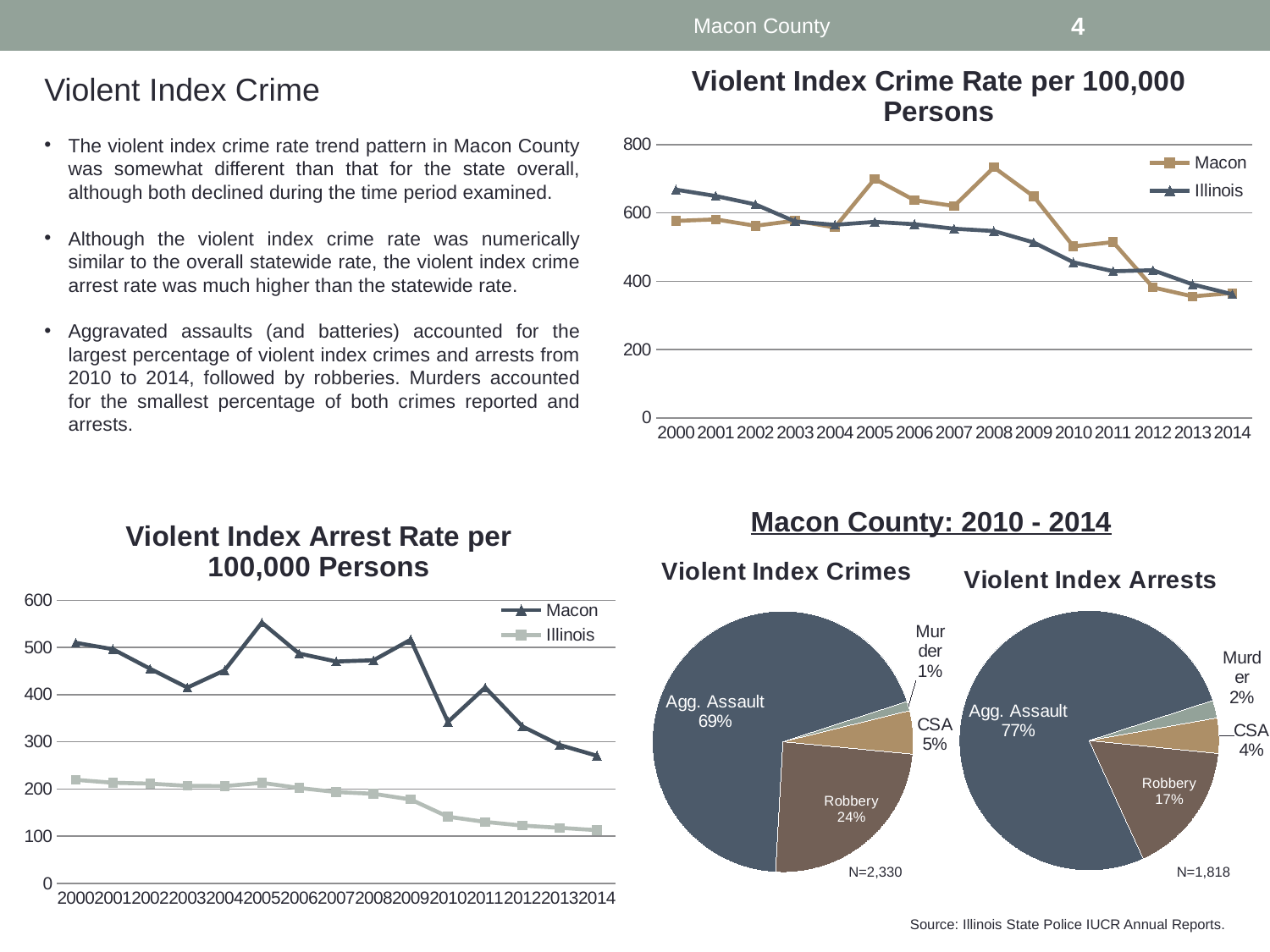
In the Violent Index Arrests pie chart, which category has the smallest share? Murder In the Violent Index Arrests pie chart, what percentage is Agg. Assault? 77% In the Violent Index Arrests pie chart, what percentage is CSA? 4% How many slices does the Violent Index Crimes pie chart have? 4 How many series does the legend of the Violent Index Crime Rate per 100,000 Persons chart list? 2 What type of chart is the Violent Index Arrest Rate per 100,000 Persons chart? Line chart In the Violent Index Crimes pie chart, how many percentage points larger is Robbery than CSA? 19 percentage points In the Violent Index Arrest Rate per 100,000 Persons chart, is the Illinois value for 2014 greater or less than 200? less In the Violent Index Crimes pie chart, which category has the largest share? Agg. Assault In the Violent Index Crimes pie chart, what percentage is Robbery? 24% In the Violent Index Crime Rate per 100,000 Persons chart, is the Macon value for 2008 greater or less than 600? greater In the Violent Index Arrest Rate per 100,000 Persons chart, does the Illinois series generally rise or fall from 2000 to 2014? fall